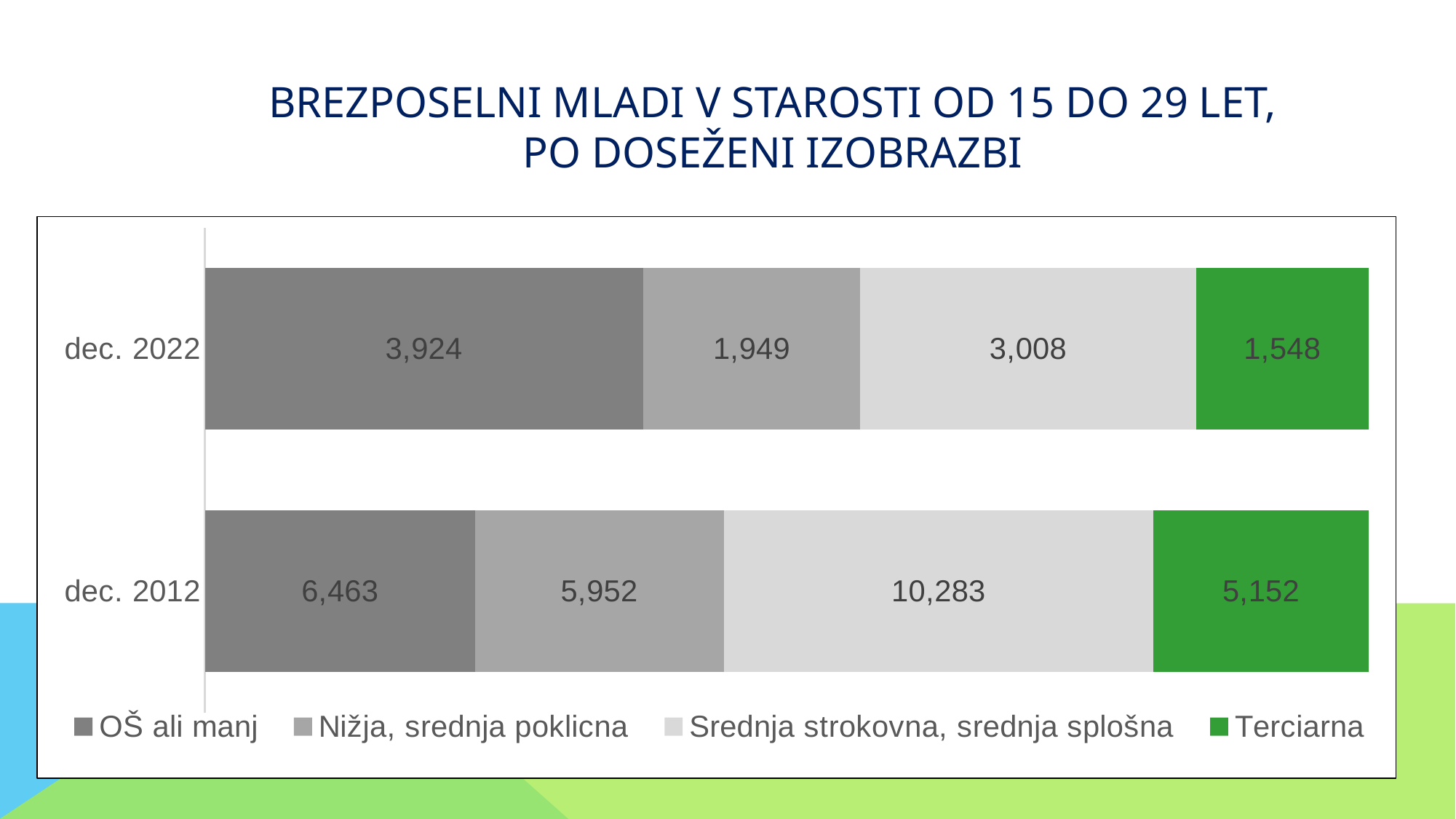
What kind of chart is shown on the slide? Stacked bar chart What is the value for 'Nižja, srednja poklicna' in dec. 2012? 5,952 How many series does the legend list? 4 What is the value for 'OŠ ali manj' in dec. 2022? 3,924 Which education category has the highest value in dec. 2012? Srednja strokovna, srednja splošna Which colour represents 'Terciarna' in the chart? Green What is the value for 'Srednja strokovna, srednja splošna' in dec. 2022? 3,008 What is the total of all four categories for dec. 2022? 10,429 Which is larger: 'OŠ ali manj' in dec. 2012 or 'OŠ ali manj' in dec. 2022? dec. 2012 What is the value for 'Terciarna' in dec. 2012? 5,152 What is the difference between the 'Terciarna' values for dec. 2012 and dec. 2022? 3,604 Which education category has the lowest value in dec. 2022? Terciarna